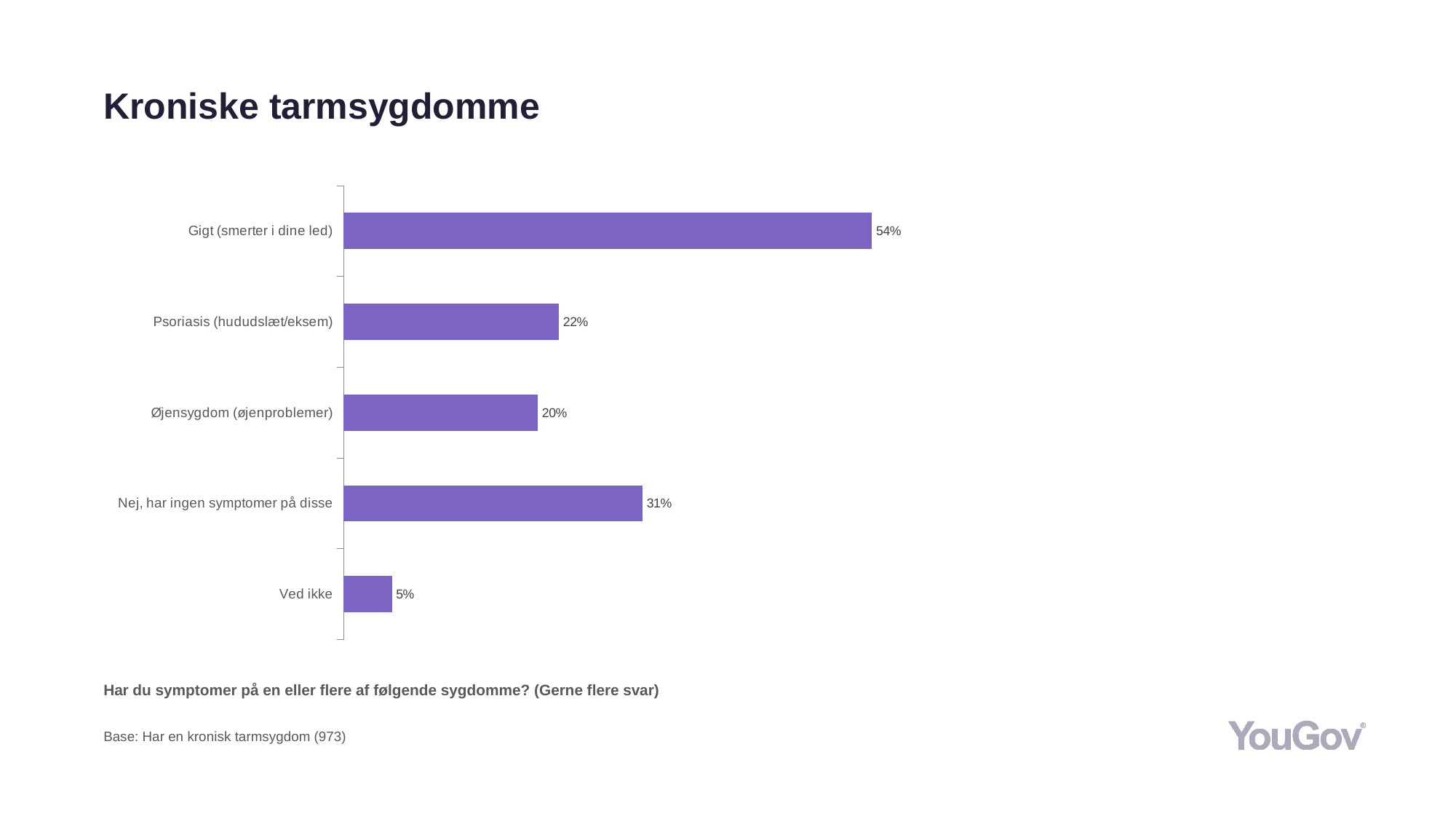
What kind of chart is shown on the slide? Bar chart What is the title of the slide? Kroniske tarmsygdomme How many categories are shown in the chart? 5 What is the value for Ved ikke? 5% Which category has the lowest value? Ved ikke What is the difference between the values for Gigt (smerter i dine led) and Nej, har ingen symptomer på disse? 23% Which category has the highest value? Gigt (smerter i dine led) Which is larger, the value for Psoriasis (hududslæt/eksem) or the value for Øjensygdom (øjenproblemer)? Psoriasis (hududslæt/eksem) What is the value for Øjensygdom (øjenproblemer)? 20% What is the value for Gigt (smerter i dine led)? 54% What is the value for Psoriasis (hududslæt/eksem)? 22% What is the value for Nej, har ingen symptomer på disse? 31%